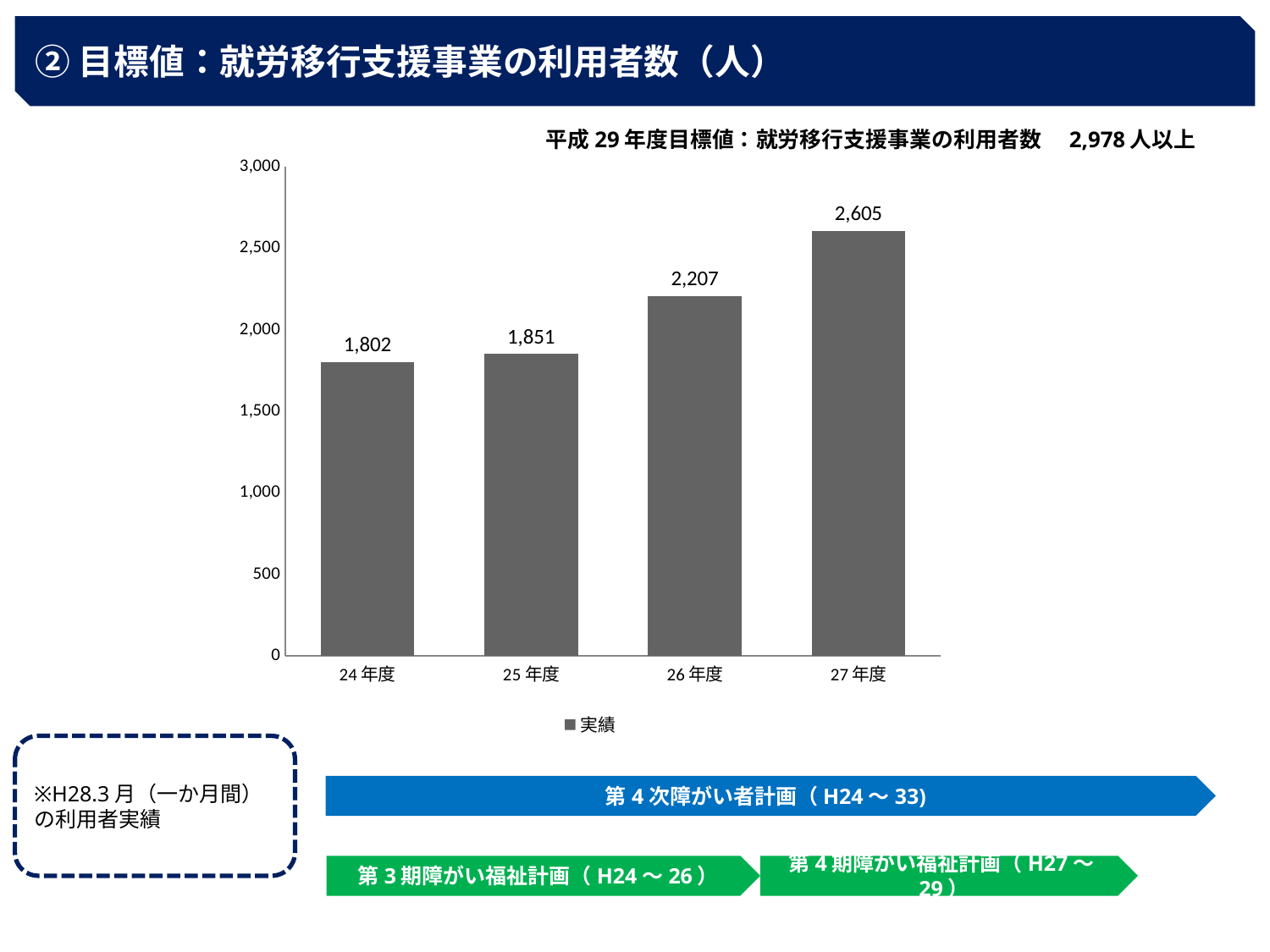
Do the values rise or fall from 24年度 to 27年度? rise What is the difference between the values for 25年度 and 24年度? 49 How many series does the legend list? 1 How many years are shown on the x axis? 4 What is the difference between the values for 27年度 and 26年度? 398 What is the value for 26年度? 2,207 What is the value for 24年度? 1,802 Which is larger, the value for 26年度 or the value for 25年度? 26年度 What is the value for 27年度? 2,605 What kind of chart is shown? bar chart Which year has the highest value? 27年度 Which year has the lowest value? 24年度